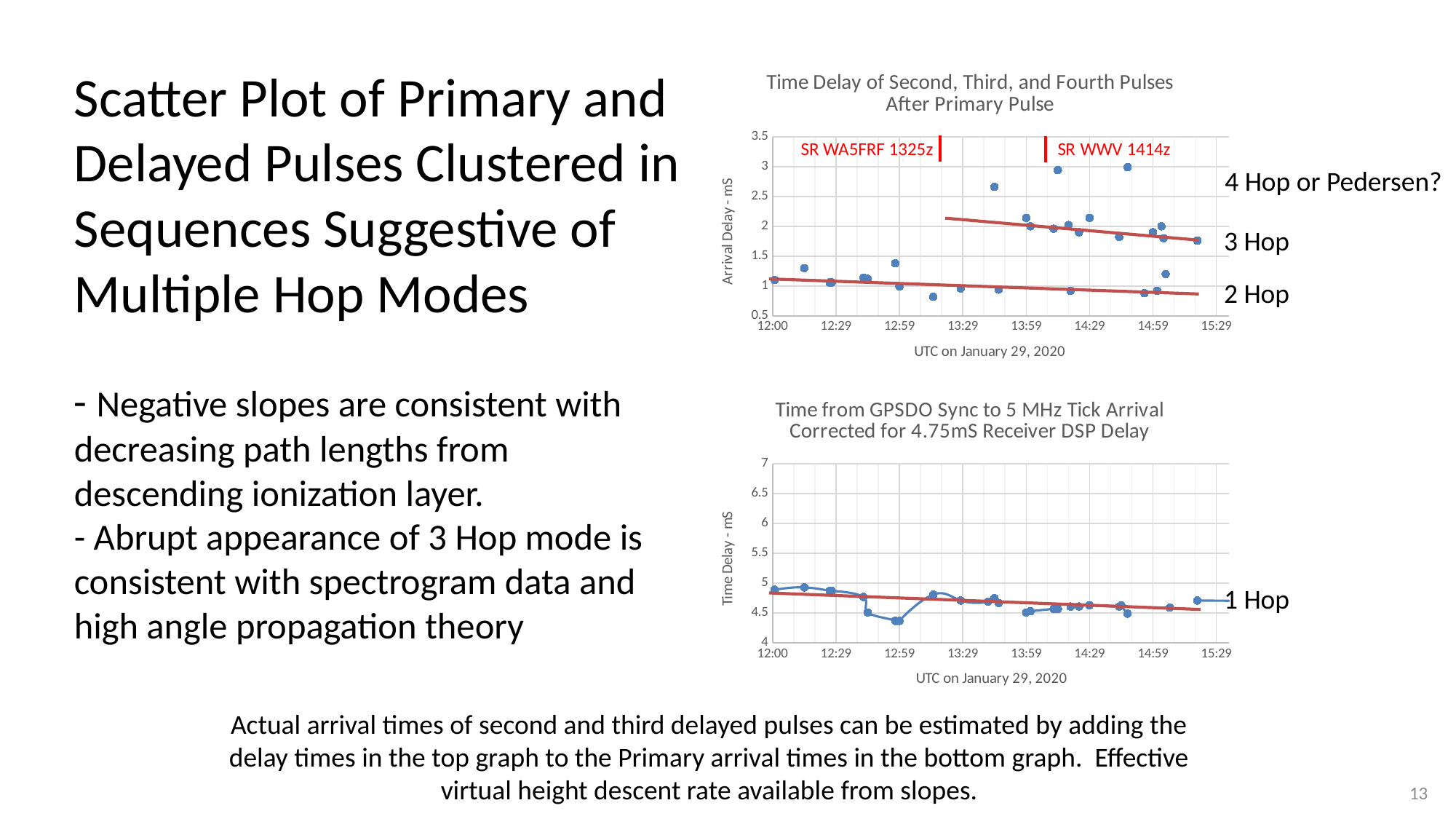
In the top chart, is the highest point near 14:14 greater or less than 2.5 mS? greater In the bottom chart, is the lowest point near 12:59 greater or less than 4.5 mS? less In the top chart, do the fitted trend lines rise or fall as time moves from 12:00 toward 15:29? Fall How many tick labels are shown on the x axis of the top chart? 8 What is the x-axis label of the bottom chart? UTC on January 29, 2020 In the top chart, is the arrival delay of the points in the '3 Hop' cluster greater or less than 1.5 mS? greater What kind of chart is the top chart, 'Time Delay of Second, Third, and Fourth Pulses After Primary Pulse'? Scatter plot In the bottom chart, 'Time from GPSDO Sync to 5 MHz Tick Arrival', does the trend line rise or fall along the x axis? Fall In the top chart, what is the label of the cluster of points with the highest arrival delay? 4 Hop or Pedersen? What is the y-axis label of the top chart? Arrival Delay - mS